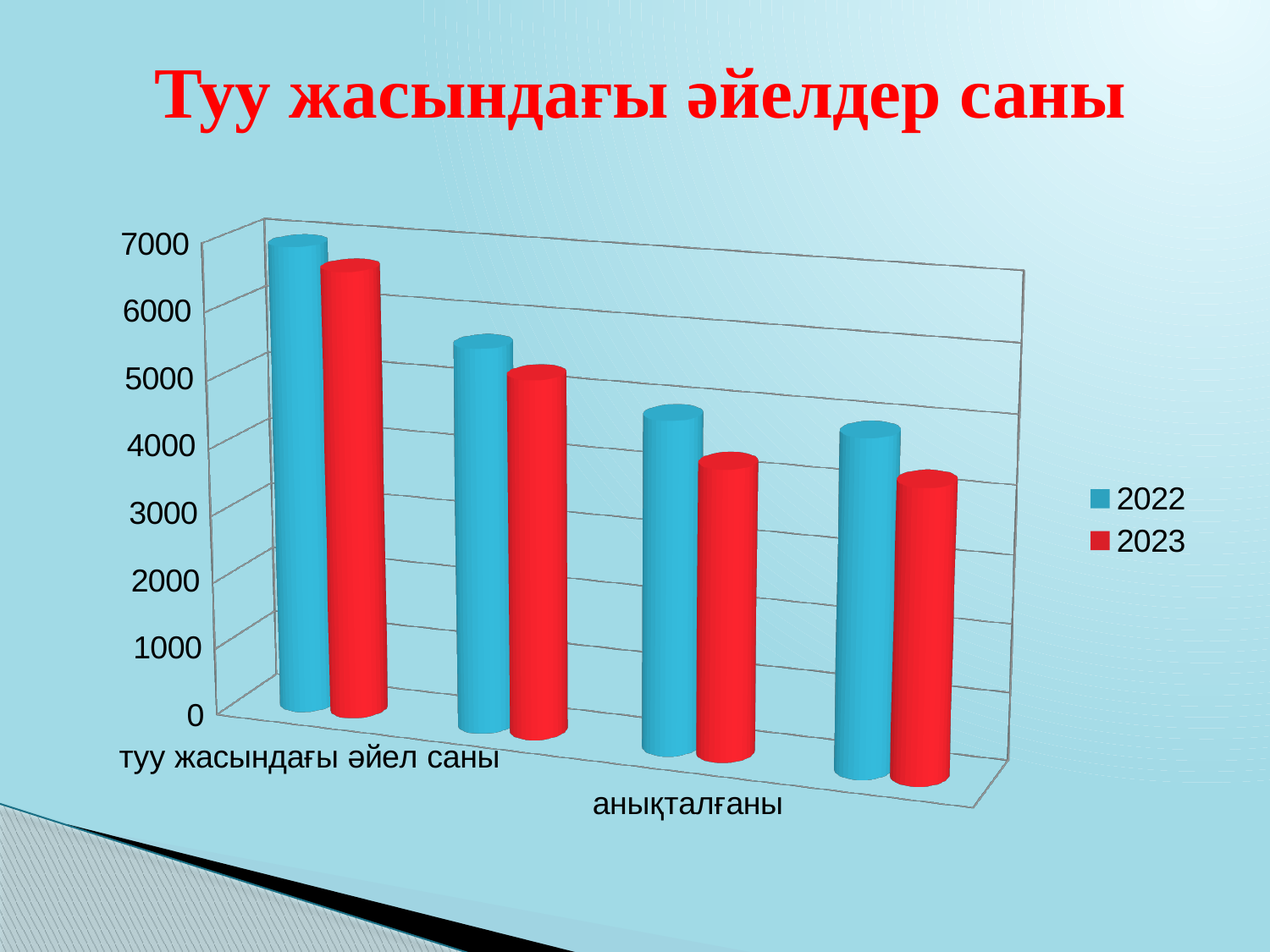
How many series does the legend list? 2 For 'туу жасындағы әйел саны', which series has the larger value, 2022 or 2023? 2022 Do the 2023 values rise or fall from left to right across the groups? fall What colour represents the 2023 series? red Is the 2023 value for 'туу жасындағы әйел саны' greater or less than 6000? greater Is the 2022 value for 'туу жасындағы әйел саны' greater or less than 6000? greater Is the 2022 value for 'анықталғаны' greater or less than 5000? less What kind of chart is shown on the slide? bar chart Which years are listed in the legend? 2022 and 2023 How many groups of bars are plotted in the chart? 4 For 'анықталғаны', which series has the larger value, 2022 or 2023? 2022